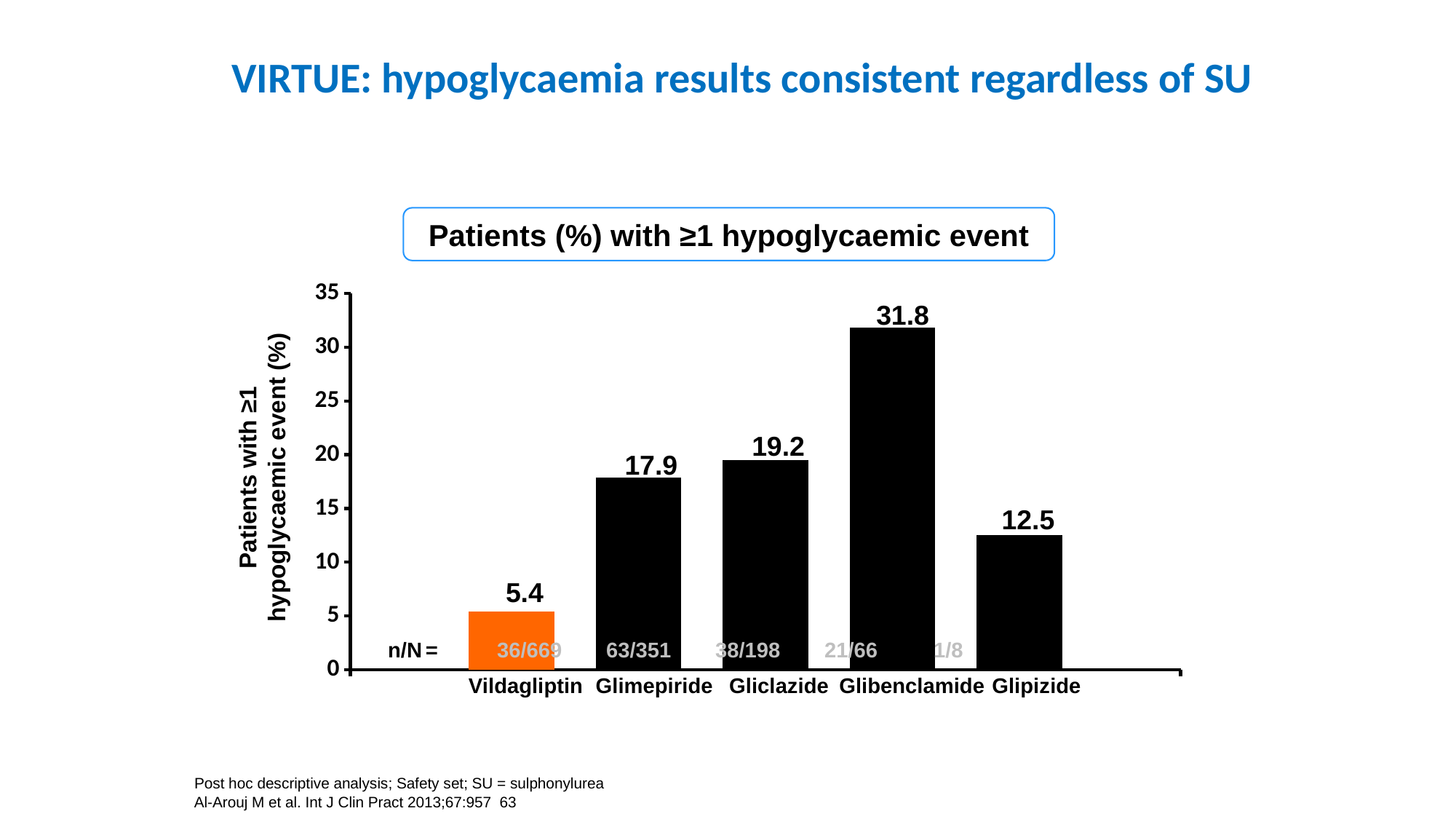
What is the difference between the values for Gliclazide and Glimepiride? 1.3 Which is larger, the value for Glimepiride or the value for Glipizide? Glimepiride How many categories are shown on the x axis? 5 What is the title shown in the box above the chart? Patients (%) with ≥1 hypoglycaemic event What is the value for Glibenclamide? 31.8 What kind of chart is shown on the slide? bar chart What is the value for Glipizide? 12.5 Is the value for Gliclazide greater or less than 15? greater What is the difference between the values for Glibenclamide and Vildagliptin? 26.4 Which category has the highest value? Glibenclamide What is the value for Vildagliptin? 5.4 Which category has the lowest value? Vildagliptin